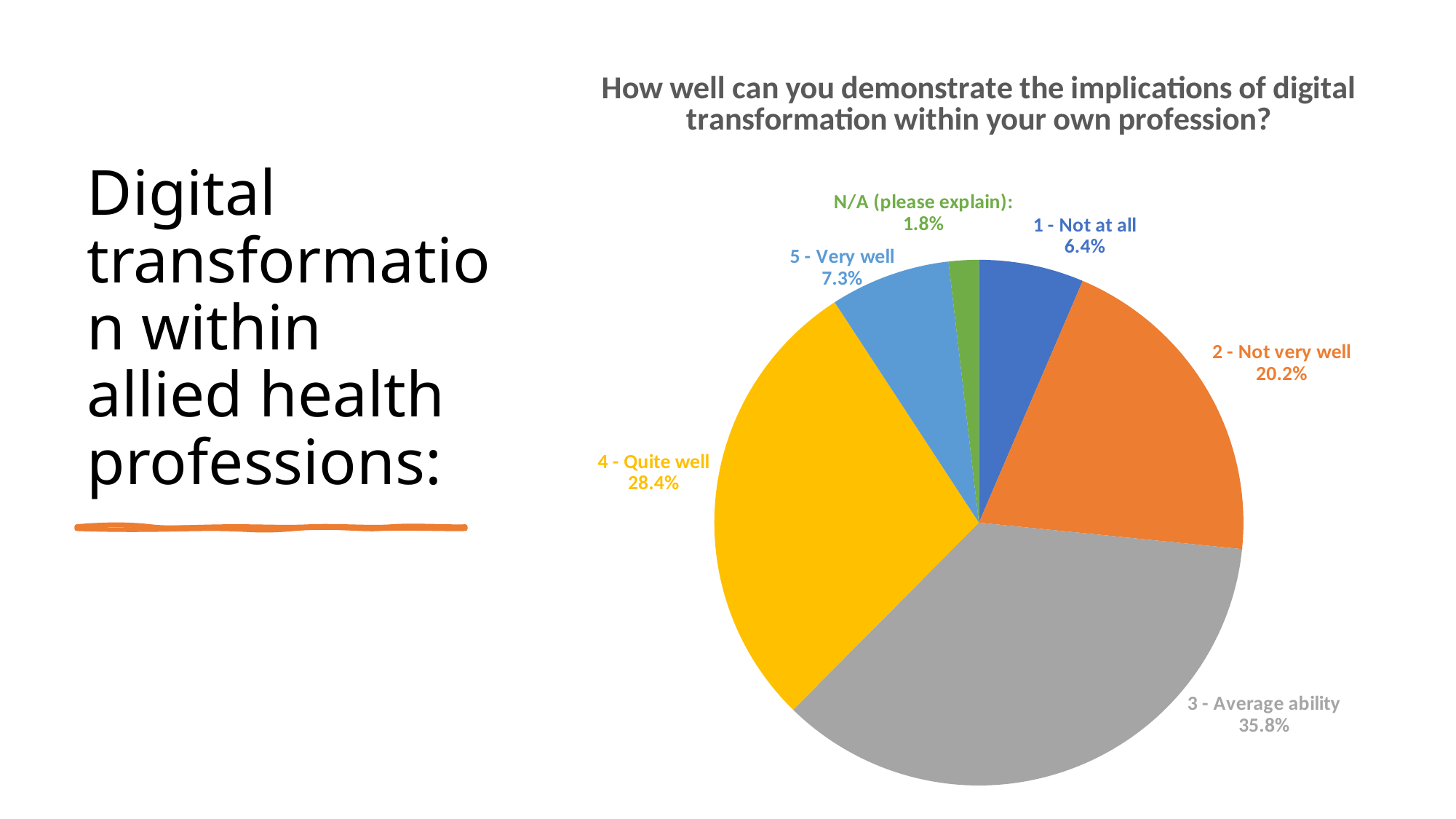
Which response category has the smallest share of the pie? N/A (please explain): How many categories are shown in the pie chart? 6 What percentage of respondents answered "4 - Quite well"? 28.4% What is the combined share of "4 - Quite well" and "5 - Very well"? 35.7% What percentage of respondents answered "3 - Average ability"? 35.8% What is the title of the pie chart? How well can you demonstrate the implications of digital transformation within your own profession? Which is larger: the share for "2 - Not very well" or the share for "5 - Very well"? 2 - Not very well What kind of chart is shown on the slide? Pie chart What percentage of respondents answered "1 - Not at all"? 6.4% Which response category has the largest share of the pie? 3 - Average ability What percentage of respondents answered "N/A (please explain):"? 1.8% What is the difference in percentage points between "3 - Average ability" and "4 - Quite well"? 7.4